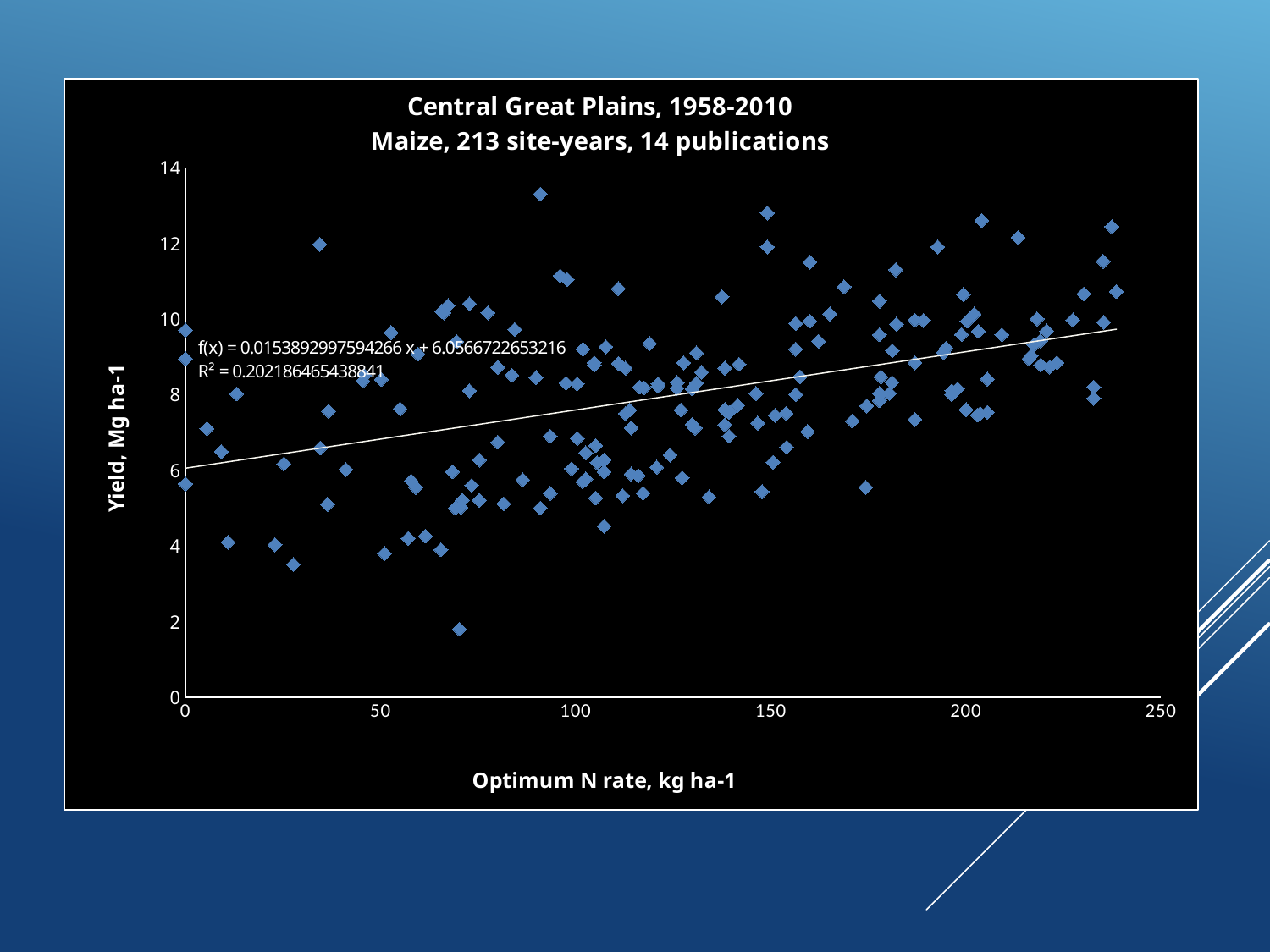
What kind of chart is shown on the slide? Scatter plot According to the chart title, how many site-years of maize data are plotted? 213 What is the maximum value shown on the x axis? 250 What is the maximum value shown on the y axis? 14 Is the lowest yield value plotted greater or less than 2? less Is the highest yield value plotted greater or less than 12? greater What is the title of the chart? Central Great Plains, 1958-2010 Maize, 213 site-years, 14 publications What is the R² value shown for the trendline? 0.202186465438841 Is the slope of the trendline positive or negative? Positive What is the equation of the trendline shown on the chart? f(x) = 0.0153892997594266 x + 6.0566722653216 What is the label of the y axis? Yield, Mg ha-1 Does yield tend to rise or fall as the optimum N rate increases along the x axis? Rise